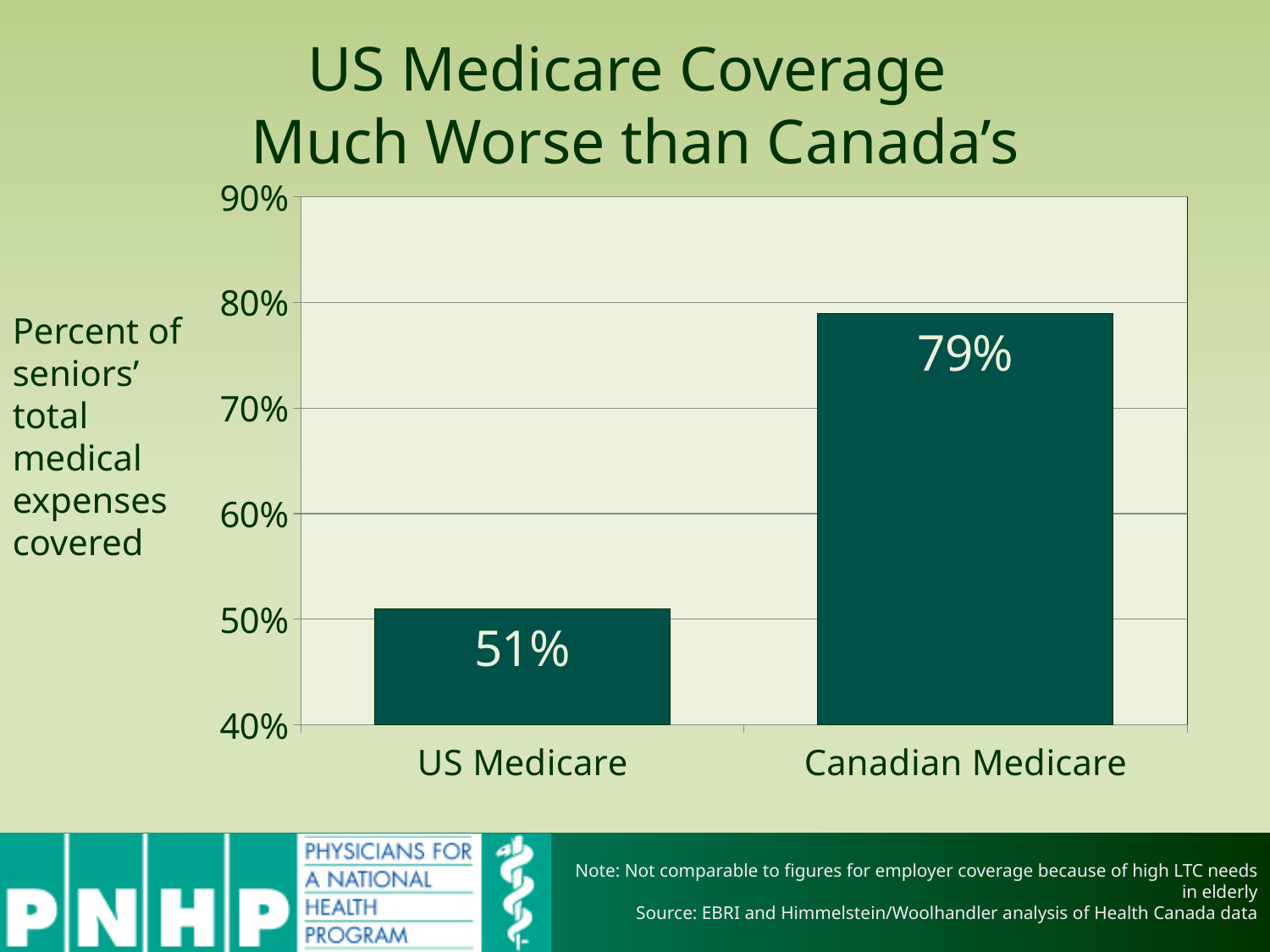
What is the lowest value shown on the vertical axis? 40% What is the title of the slide? US Medicare Coverage Much Worse than Canada's Is the value for Canadian Medicare greater or less than 70%? greater What percent of seniors' total medical expenses are covered by Canadian Medicare? 79% What kind of chart is shown on the slide? Bar chart Which category has the higher value, US Medicare or Canadian Medicare? Canadian Medicare What does the vertical axis of the chart measure? Percent of seniors' total medical expenses covered What percent of seniors' total medical expenses are covered by US Medicare? 51% How many categories are shown on the chart? 2 What is the difference between the Canadian Medicare and US Medicare values? 28 percentage points Which category has the lowest value on the chart? US Medicare Is the value for US Medicare greater or less than 60%? less